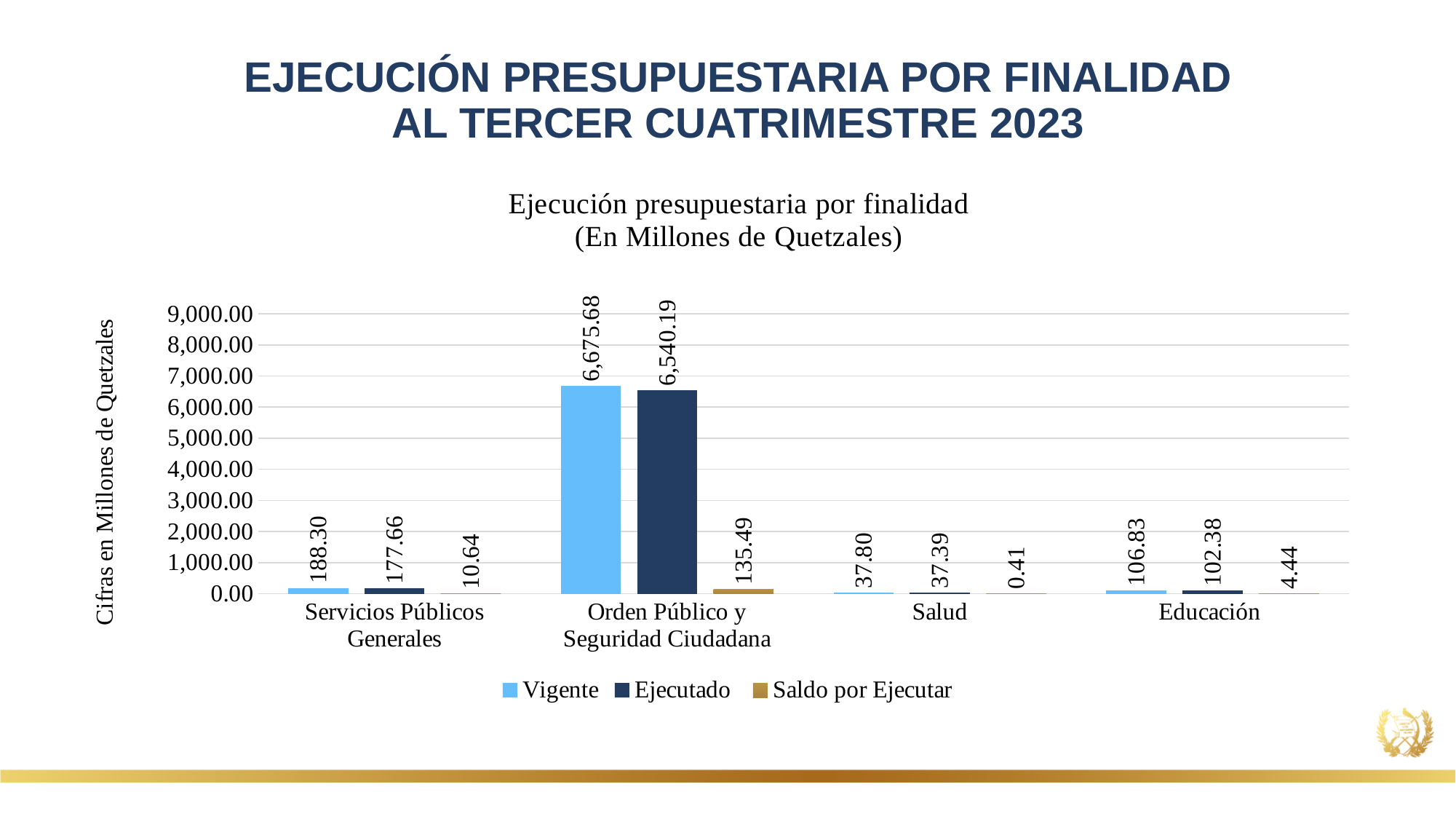
What is the Vigente value for Orden Público y Seguridad Ciudadana? 6,675.68 Which category has the lowest Ejecutado value? Salud What is the Saldo por Ejecutar value for Salud? 0.41 What is the difference between the Vigente and Ejecutado values for Orden Público y Seguridad Ciudadana? 135.49 Which category has the highest Vigente value? Orden Público y Seguridad Ciudadana What is the difference between the Vigente values for Servicios Públicos Generales and Salud? 150.50 Which is larger, the Saldo por Ejecutar for Servicios Públicos Generales or for Educación? Servicios Públicos Generales What kind of chart is shown on the slide? Bar chart How many categories are shown on the x axis? 4 What is the Ejecutado value for Educación? 102.38 What is the Ejecutado value for Servicios Públicos Generales? 177.66 How many series does the legend list? 3